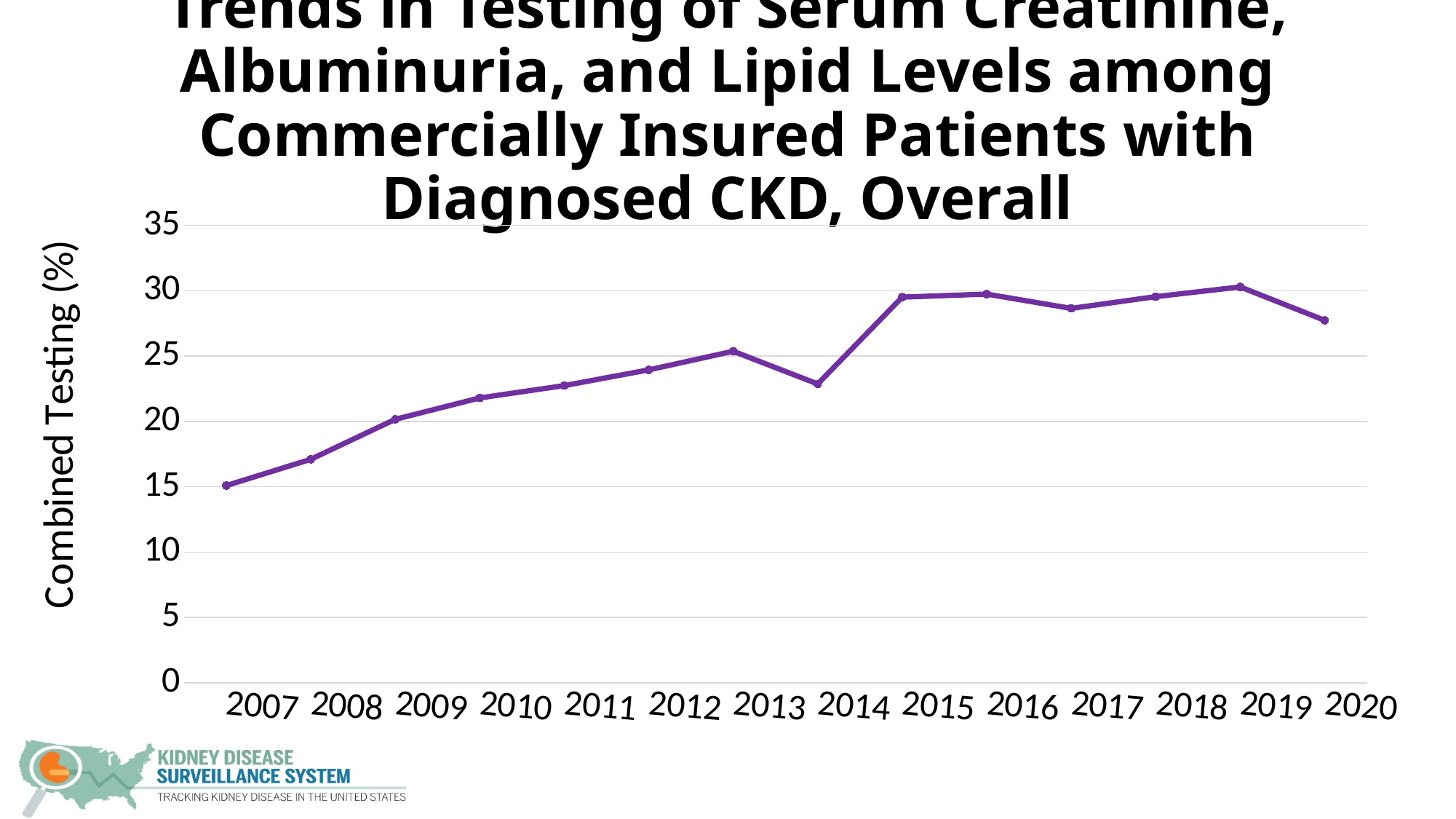
What kind of chart is shown on the slide? line chart Which year has the larger value, 2013 or 2014? 2013 Which year has the lowest combined testing percentage? 2007 Which year has the highest combined testing percentage? 2019 Is the value for 2020 greater or less than 25? greater Is the value for 2014 greater or less than 25? less What is the label of the y axis? Combined Testing (%) Which year has the larger value, 2014 or 2015? 2015 Is the value for 2007 greater or less than 20? less How many years are plotted on the x axis? 14 Overall, do the values rise or fall from 2007 to 2020? rise